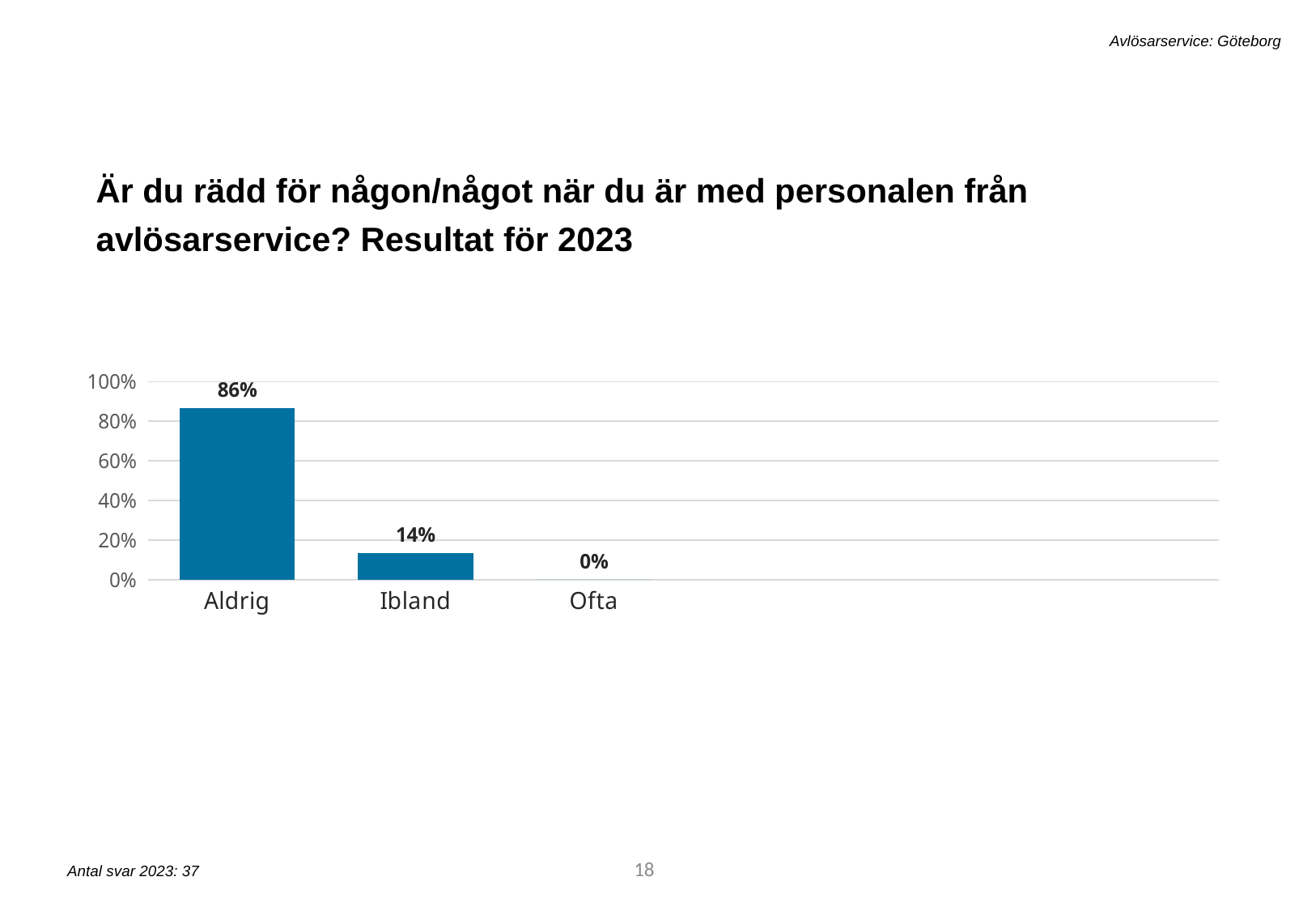
Which category has the highest value? Aldrig How many categories are shown on the x axis? 3 What is the value for Aldrig? 86% What is the difference between the values for Aldrig and Ibland? 72% What kind of chart is shown on the slide? bar chart What is the value for Ofta? 0% Which is larger, the value for Ibland or the value for Ofta? Ibland Is the value for Ibland greater or less than 20%? less Is the value for Aldrig greater or less than 80%? greater Do the values rise or fall from left to right along the x axis? fall What is the value for Ibland? 14% Which category has the lowest value? Ofta